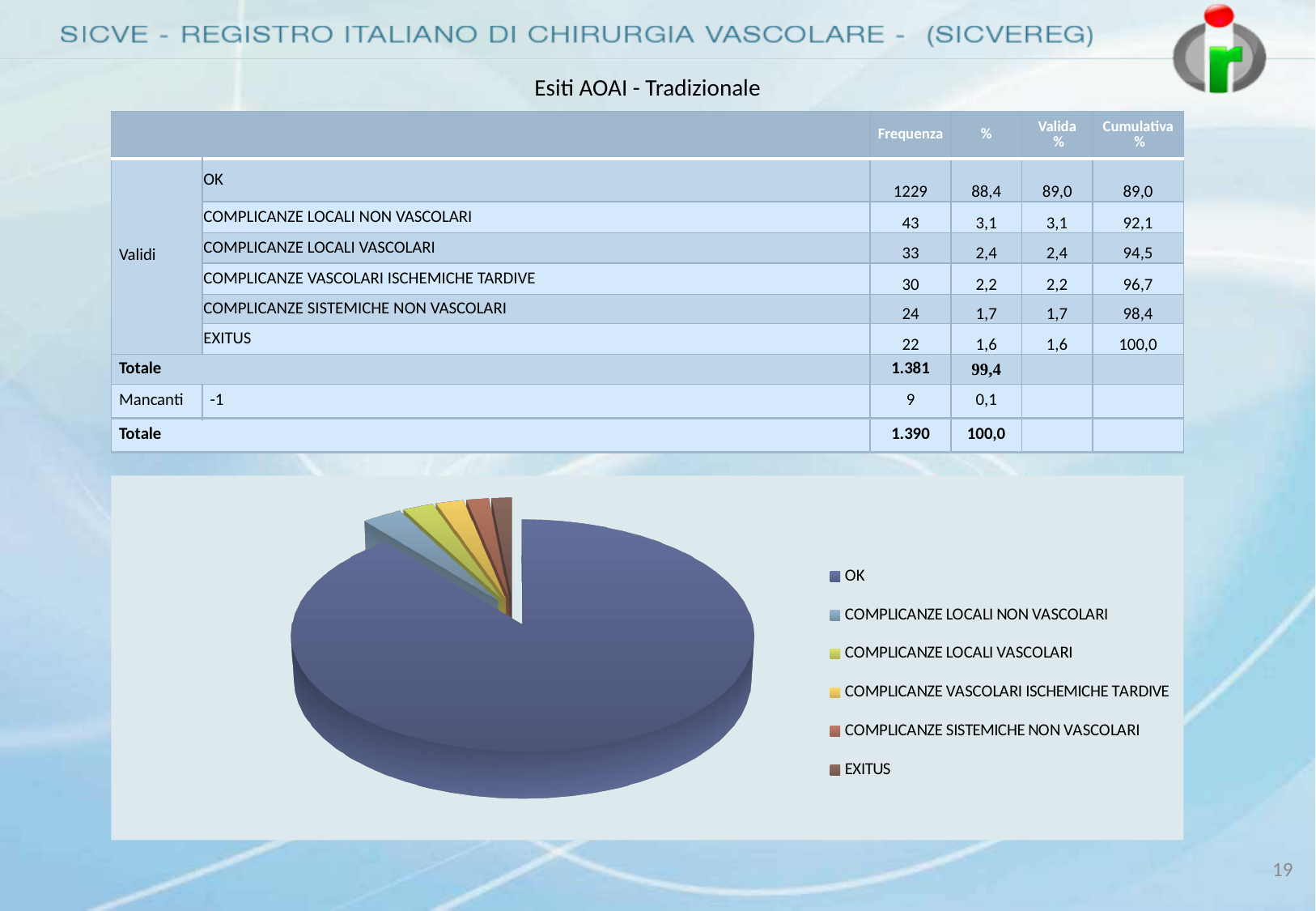
According to the table, what is the frequency for EXITUS? 22 What colour is the OK slice in the pie chart? blue Which slice is larger in the pie chart: OK or COMPLICANZE SISTEMICHE NON VASCOLARI? OK What kind of chart is shown on the slide? pie chart What is the Valida % for OK in the table? 89,0 What is the difference in frequency between COMPLICANZE LOCALI NON VASCOLARI (43) and COMPLICANZE LOCALI VASCOLARI (33)? 10 Which category has the largest slice in the pie chart? OK What is the title of the slide above the table and pie chart? Esiti AOAI - Tradizionale What percentage (%) does the table give for COMPLICANZE LOCALI NON VASCOLARI? 3,1 How many categories does the pie chart's legend list? 6 According to the table, what is the frequency for the OK category shown in the pie chart? 1229 Which category has the smallest slice in the pie chart? EXITUS